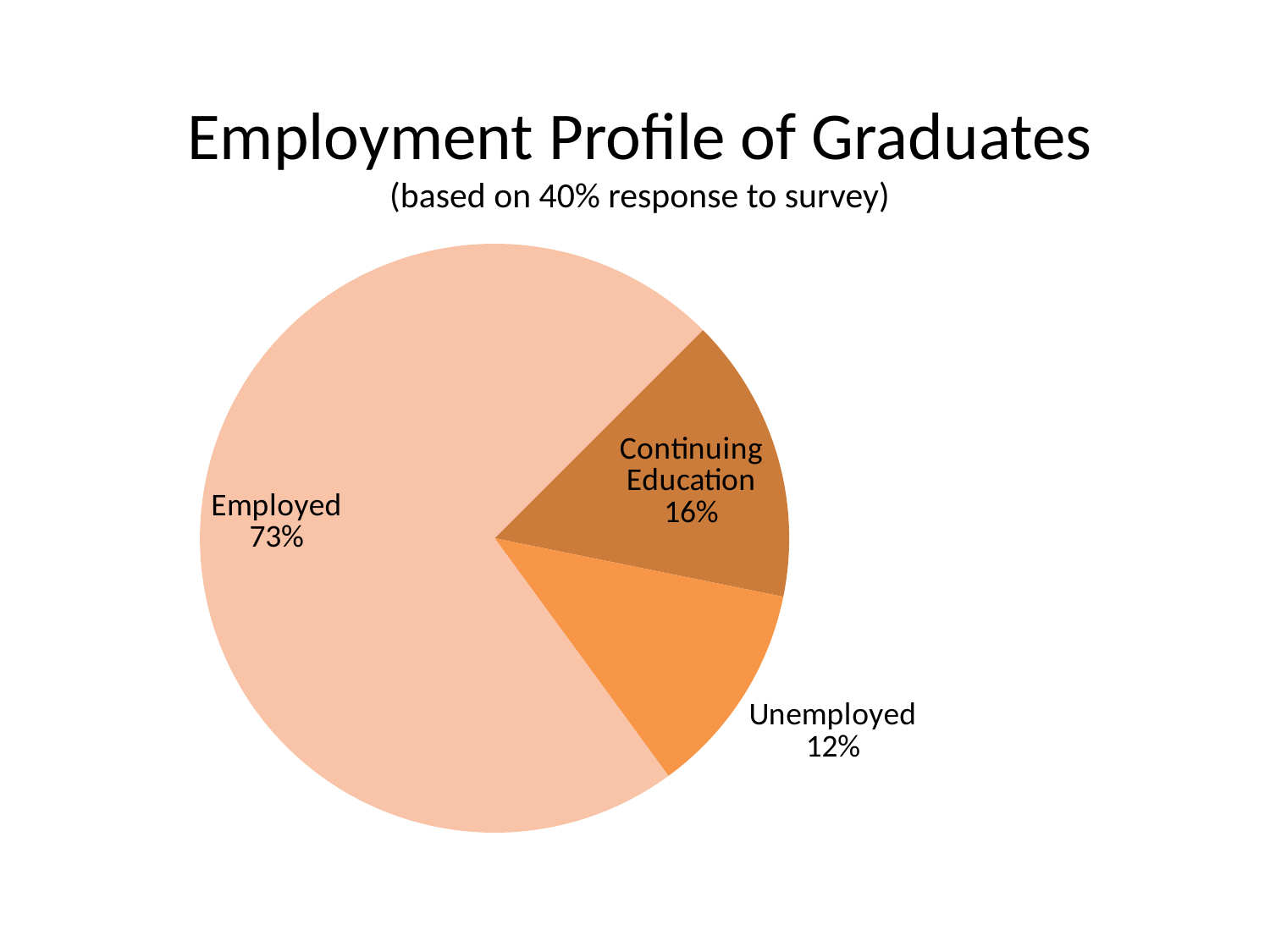
What share of graduates are in Continuing Education? 16% What is the difference in percentage points between Employed and Continuing Education? 57 Which category has the largest slice of the pie? Employed What is the title of the chart? Employment Profile of Graduates What kind of chart is shown on the slide? pie chart What is the difference in percentage points between Continuing Education and Unemployed? 4 What share of graduates are Unemployed? 12% According to the subtitle, what response rate to the survey is the chart based on? 40% What share of graduates are Employed? 73% Which category has the smallest slice of the pie? Unemployed How many slices does the pie chart have? 3 Which is larger, the Continuing Education slice or the Unemployed slice? Continuing Education